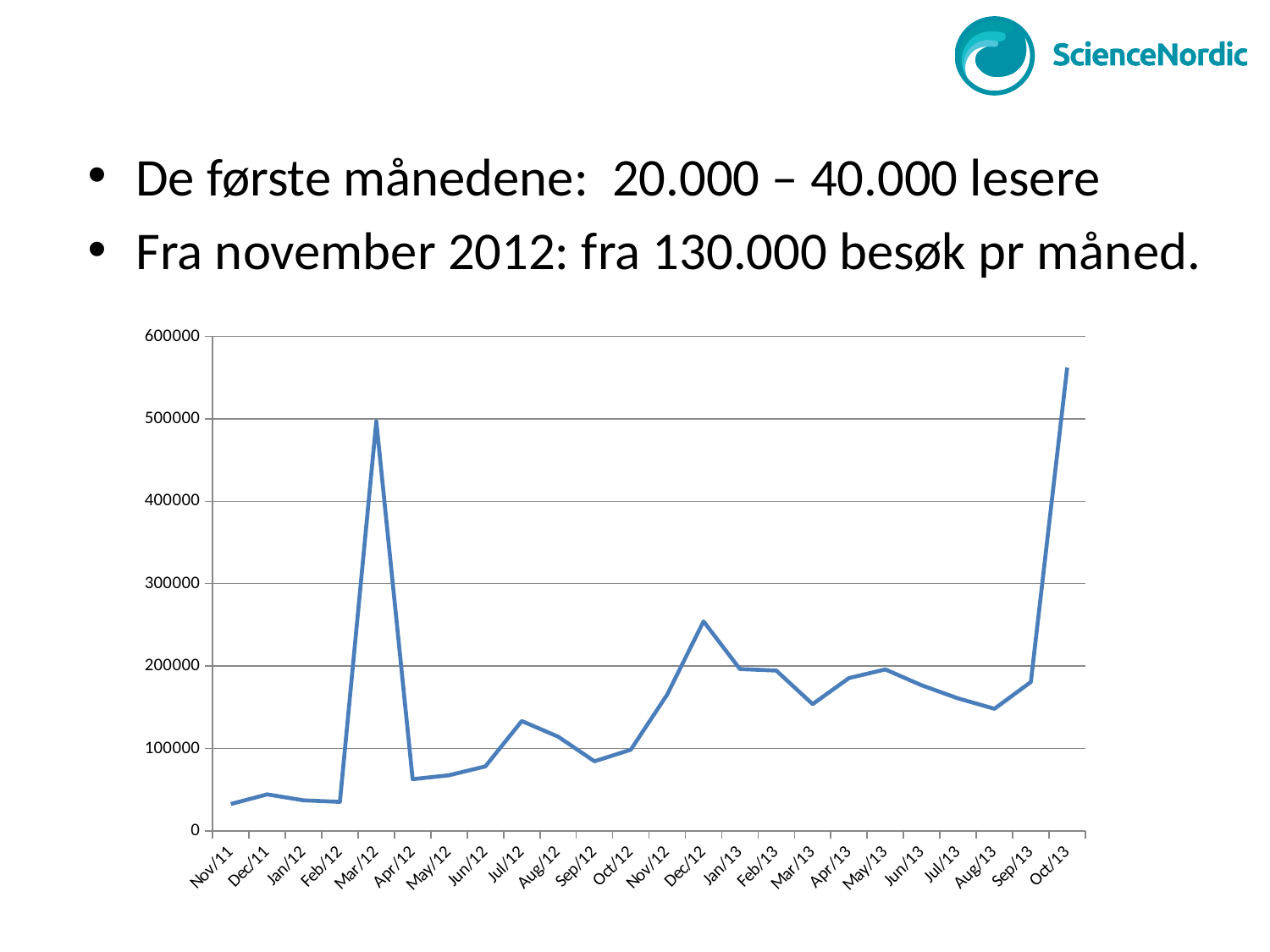
Is the value for Apr/12 greater or less than 100000? less Do the values generally rise or fall from Dec/12 to Aug/13? fall Is the value for Dec/12 greater or less than 200000? greater Which month has the highest value in the chart? Oct/13 Is the value for Aug/13 greater or less than 200000? less Which is larger, the value for Jul/12 or the value for Sep/12? Jul/12 How many months are plotted along the x axis of the chart? 24 Which is larger, the value for Mar/12 or the value for Dec/12? Mar/12 What kind of chart is shown on the slide? line chart What is the first month shown on the x axis of the chart? Nov/11